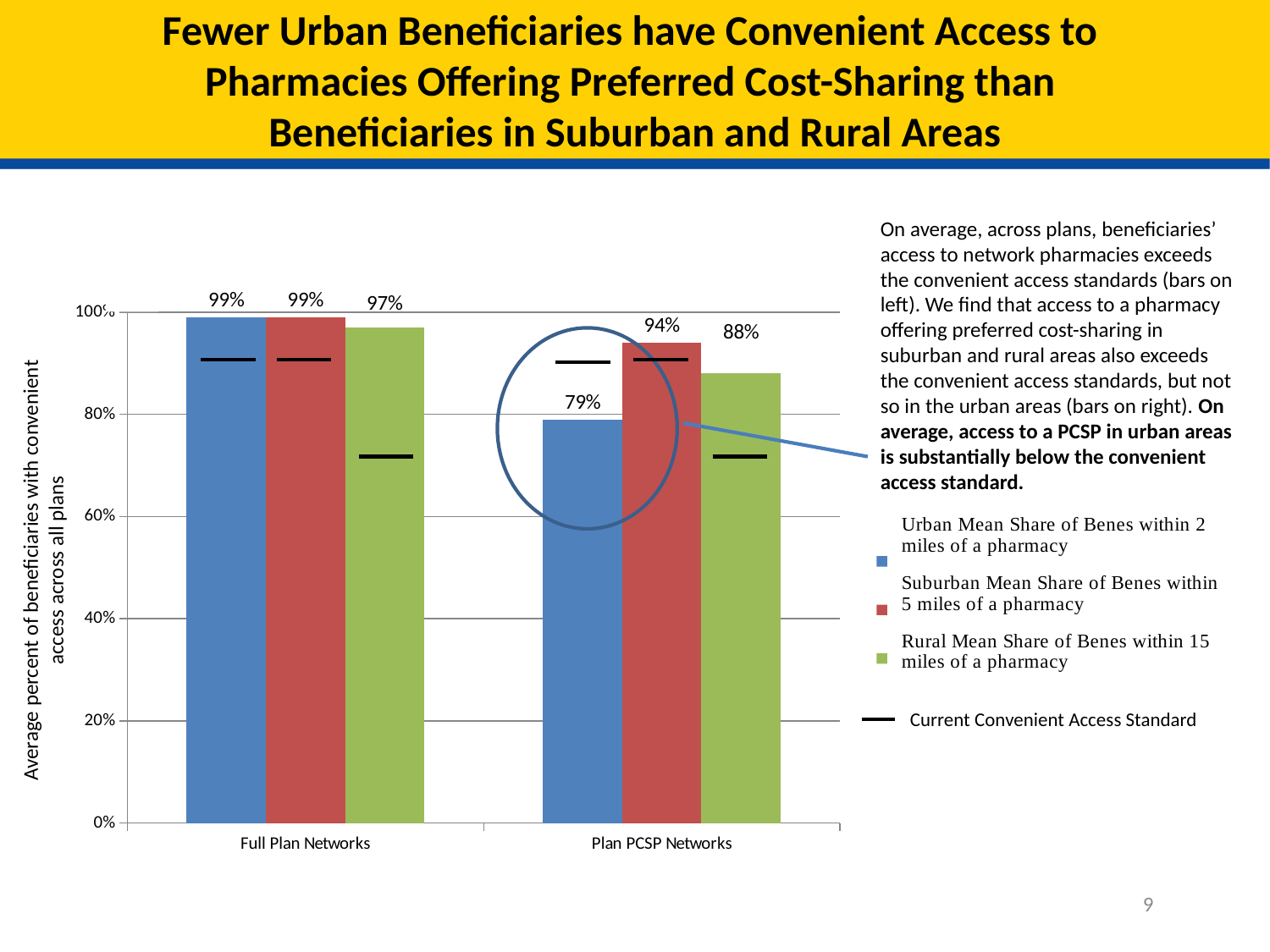
How many entries does the legend list? 4 How many categories are shown on the x axis? 2 Which series has the lowest value under Plan PCSP Networks? Urban Mean Share of Benes within 2 miles of a pharmacy What is the value for Urban Mean Share of Benes within 2 miles of a pharmacy under Plan PCSP Networks? 79% Which is larger: the Rural value under Full Plan Networks or the Rural value under Plan PCSP Networks? Full Plan Networks What type of chart is shown on the slide? Bar chart What is the value for Rural Mean Share of Benes within 15 miles of a pharmacy under Full Plan Networks? 97% What is the difference between the Urban value under Full Plan Networks and the Urban value under Plan PCSP Networks? 20% What is the value for Rural Mean Share of Benes within 15 miles of a pharmacy under Plan PCSP Networks? 88% Which series has the highest value under Plan PCSP Networks? Suburban Mean Share of Benes within 5 miles of a pharmacy What is the value for Suburban Mean Share of Benes within 5 miles of a pharmacy under Plan PCSP Networks? 94% What is the difference between the Suburban and Rural values under Plan PCSP Networks? 6%